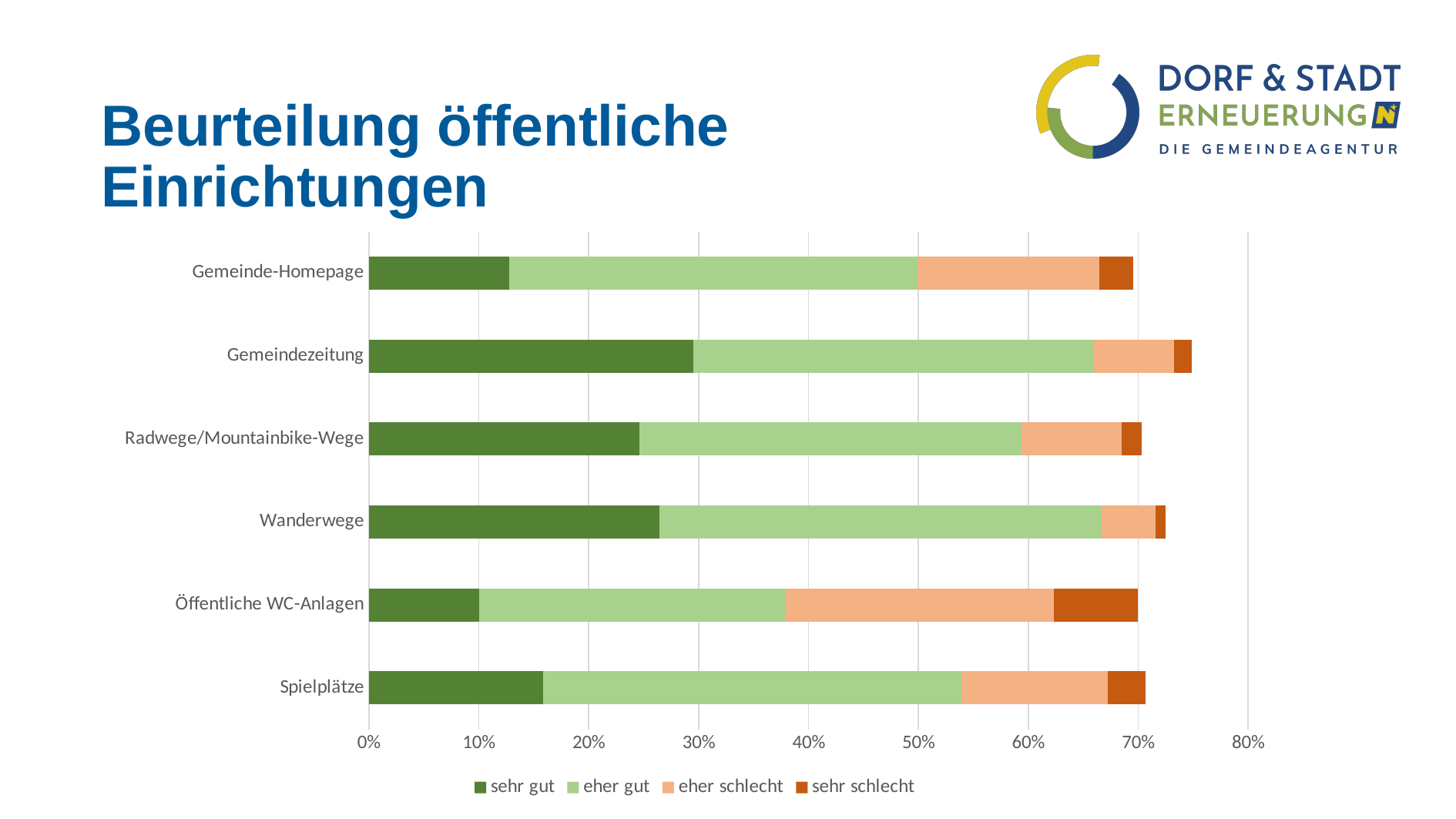
Which has a larger "sehr gut" segment, Gemeindezeitung or Gemeinde-Homepage? Gemeindezeitung Which category has the smallest "sehr gut" segment? Öffentliche WC-Anlagen What is the title of the slide containing the chart? Beurteilung öffentliche Einrichtungen Is the "sehr gut" value for Spielplätze greater or less than 20%? less What kind of chart is shown on the slide? bar chart Which legend entry is shown in dark orange? sehr schlecht Which category has the largest "sehr gut" segment? Gemeindezeitung How many series does the legend list? 4 Which category has the largest "sehr schlecht" segment? Öffentliche WC-Anlagen Which category has the largest "eher schlecht" segment? Öffentliche WC-Anlagen How many categories are shown on the chart? 6 Is the "sehr gut" value for Gemeindezeitung greater or less than 20%? greater